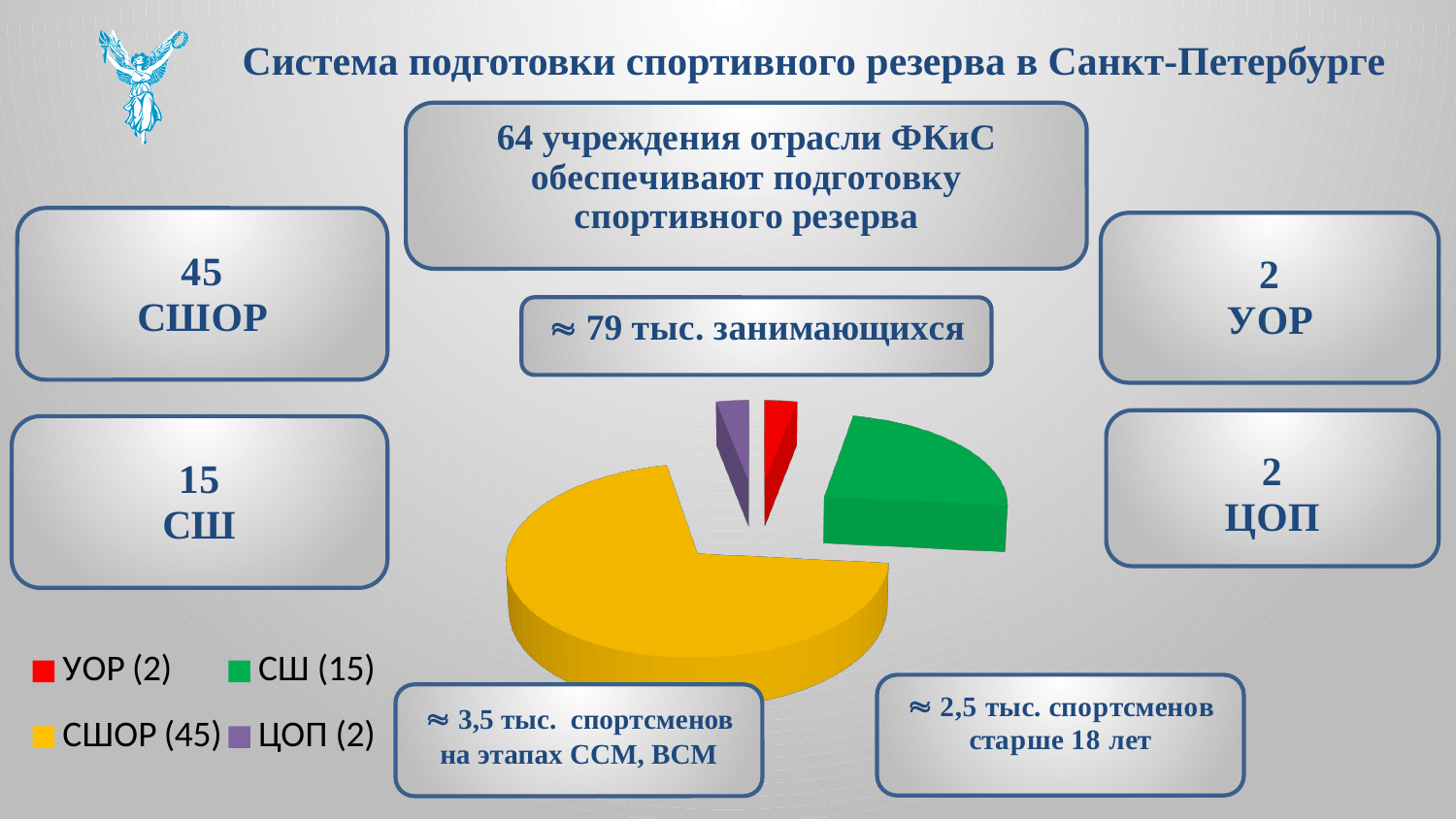
Which is larger, the value for СШ or the value for УОР? СШ Which category is shown in green in the pie chart? СШ Which category has the largest slice in the pie chart? СШОР How many categories does the pie chart have? 4 What is the value for ЦОП in the pie chart? 2 What is the total of all the values in the pie chart? 64 What is the value for СШОР in the pie chart? 45 What is the difference between the values for СШОР and СШ? 30 What type of chart is shown on the slide? pie chart What is the value for УОР in the pie chart? 2 What is the value for СШ in the pie chart? 15 What colour is the СШОР slice in the pie chart? yellow